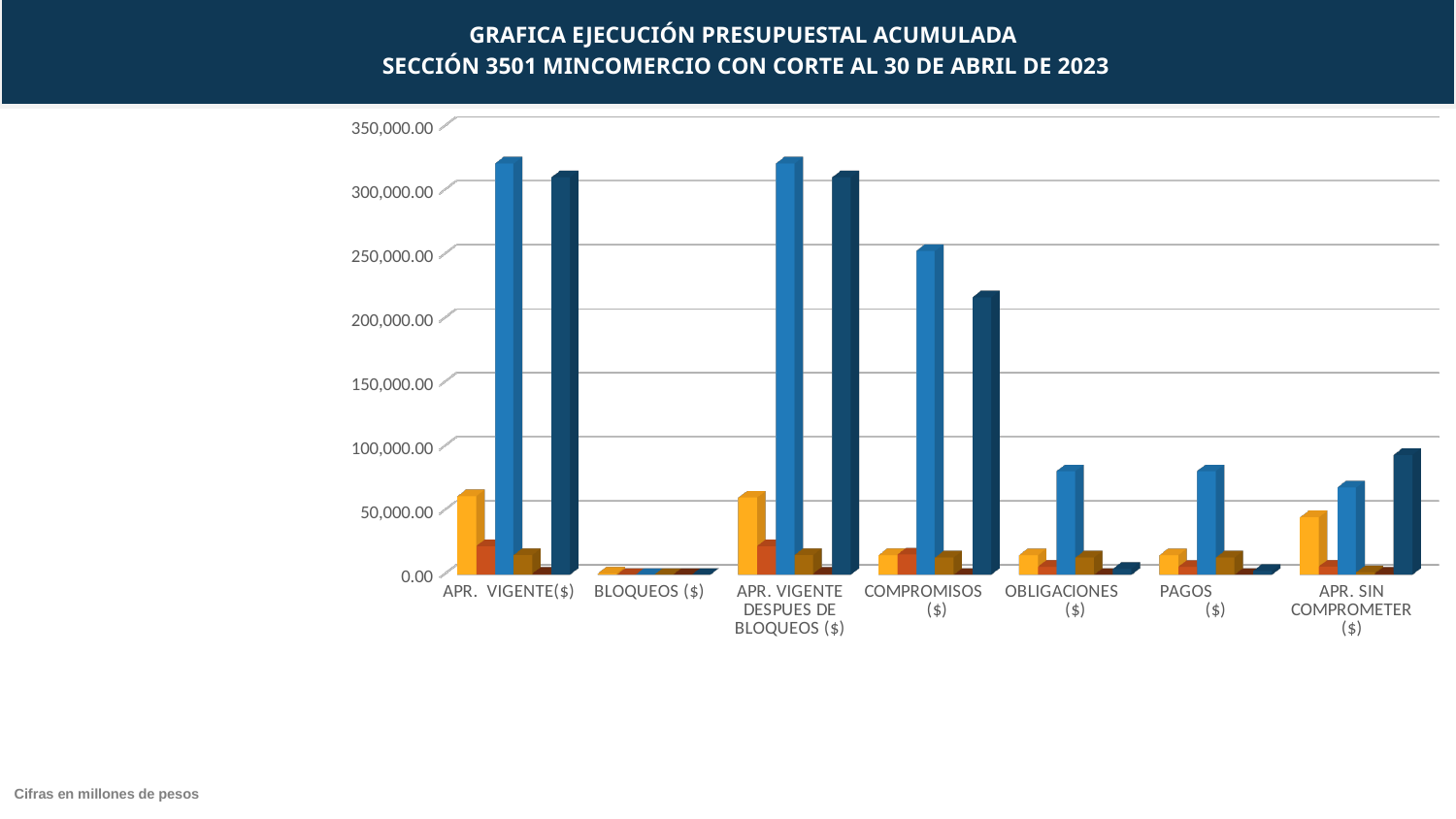
Is the value of the light blue bar for COMPROMISOS ($) greater or less than 300,000.00? less Is the value of the yellow bar for APR. SIN COMPROMETER ($) greater or less than 50,000.00? less Which category has the lowest bars in the chart? BLOQUEOS ($) Is the value of the tallest (light blue) bar for APR. VIGENTE($) greater or less than 300,000.00? greater How many categories are shown along the x axis of the chart? 7 Which is larger: the light blue bar for COMPROMISOS ($) or the light blue bar for PAGOS ($)? COMPROMISOS ($) Which is larger: the dark blue bar for APR. SIN COMPROMETER ($) or the dark blue bar for PAGOS ($)? APR. SIN COMPROMETER ($) According to the note at the bottom of the slide, in what units are the figures expressed? millones de pesos What kind of chart is shown on the slide? bar chart